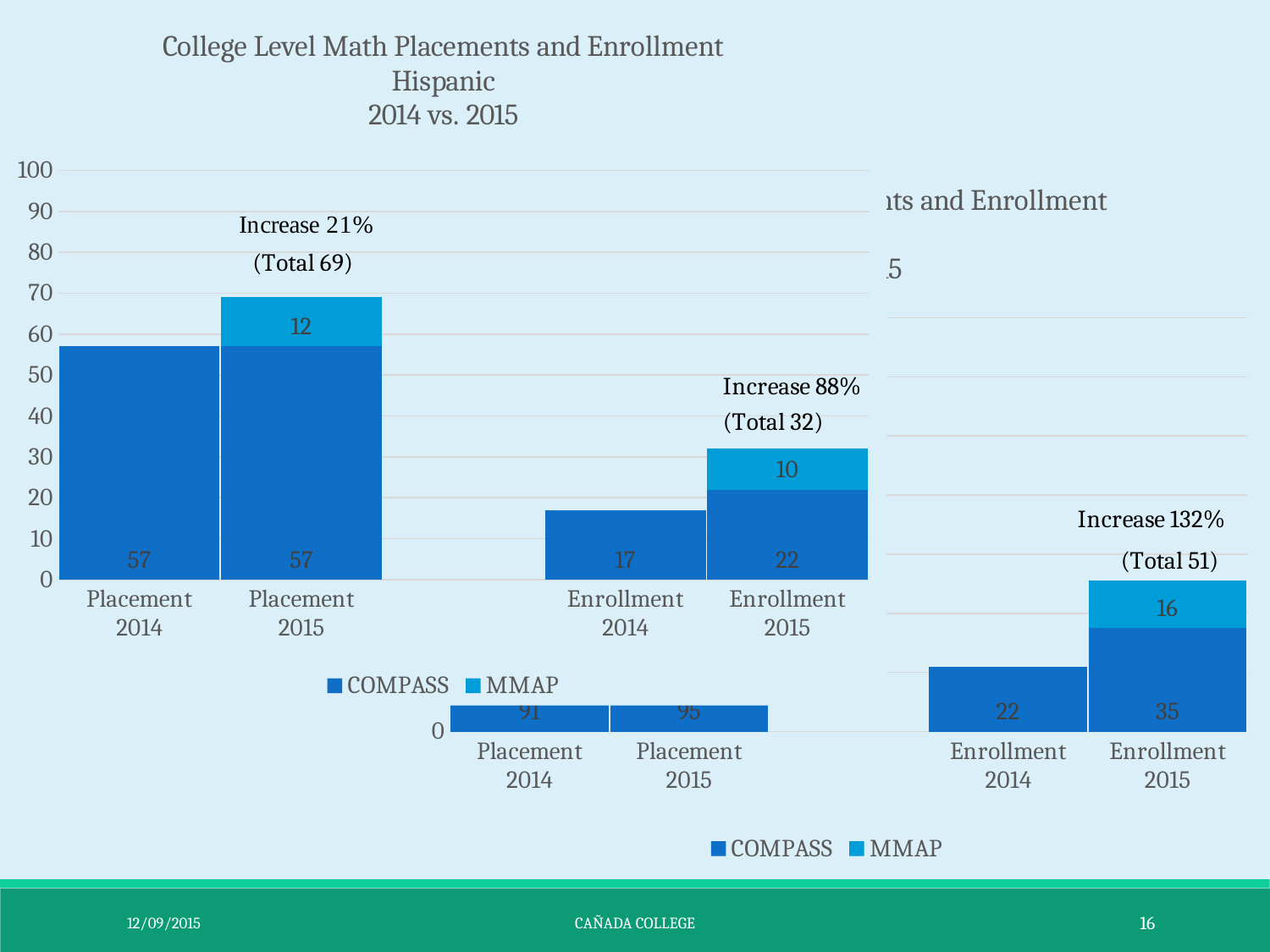
What kind of chart is the chart titled 'College Level Math Placements and Enrollment Hispanic 2014 vs. 2015'? stacked bar chart In the chart titled 'College Level Math Placements and Enrollment Hispanic 2014 vs. 2015', what is the total of the stacked bar for Enrollment 2015? 32 In the chart titled 'College Level Math Placements and Enrollment Hispanic 2014 vs. 2015', what is the COMPASS value for Placement 2014? 57 In the chart titled 'College Level Math Placements and Enrollment Hispanic 2014 vs. 2015', how many series does the legend list? 2 In the chart titled 'College Level Math Placements and Enrollment Hispanic 2014 vs. 2015', which category has the lowest COMPASS value? Enrollment 2014 In the chart titled 'College Level Math Placements and Enrollment Hispanic 2014 vs. 2015', what is the total of the stacked bar for Placement 2015? 69 In the partially hidden chart on the right of the slide, what is the MMAP value for Enrollment 2015? 16 In the chart titled 'College Level Math Placements and Enrollment Hispanic 2014 vs. 2015', what percentage increase is annotated above the Enrollment 2015 bar? 88% In the chart titled 'College Level Math Placements and Enrollment Hispanic 2014 vs. 2015', what is the difference between the MMAP values for Placement 2015 and Enrollment 2015? 2 In the partially hidden chart on the right of the slide, what is the total of the stacked bar for Enrollment 2015? 51 In the chart titled 'College Level Math Placements and Enrollment Hispanic 2014 vs. 2015', what is the COMPASS value for Enrollment 2014? 17 In the chart titled 'College Level Math Placements and Enrollment Hispanic 2014 vs. 2015', what is the MMAP value for Placement 2015? 12